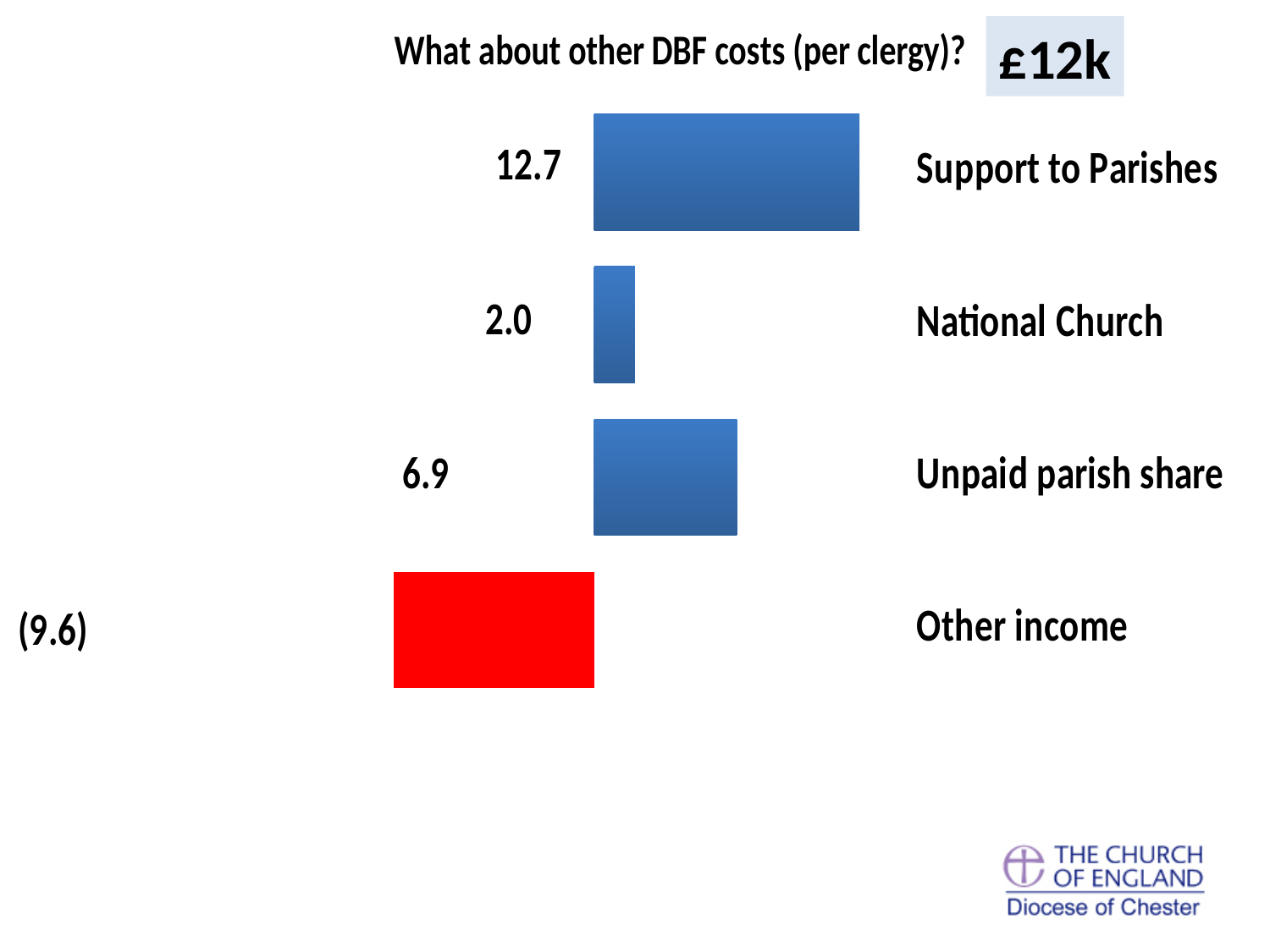
Which category is drawn with a red bar? Other income What is the title of the chart? What about other DBF costs (per clergy)? What is the value for National Church? 2.0 Which category has the largest positive bar? Support to Parishes What is the value for Unpaid parish share? 6.9 What is the difference between the values for Support to Parishes and Unpaid parish share? 5.8 Which is larger, the value for Unpaid parish share or the value for National Church? Unpaid parish share What is the value for Support to Parishes? 12.7 How many categories are shown in the chart? 4 Which category has the smallest positive bar? National Church What value is shown for Other income? (9.6) What kind of chart is shown on the slide? Bar chart